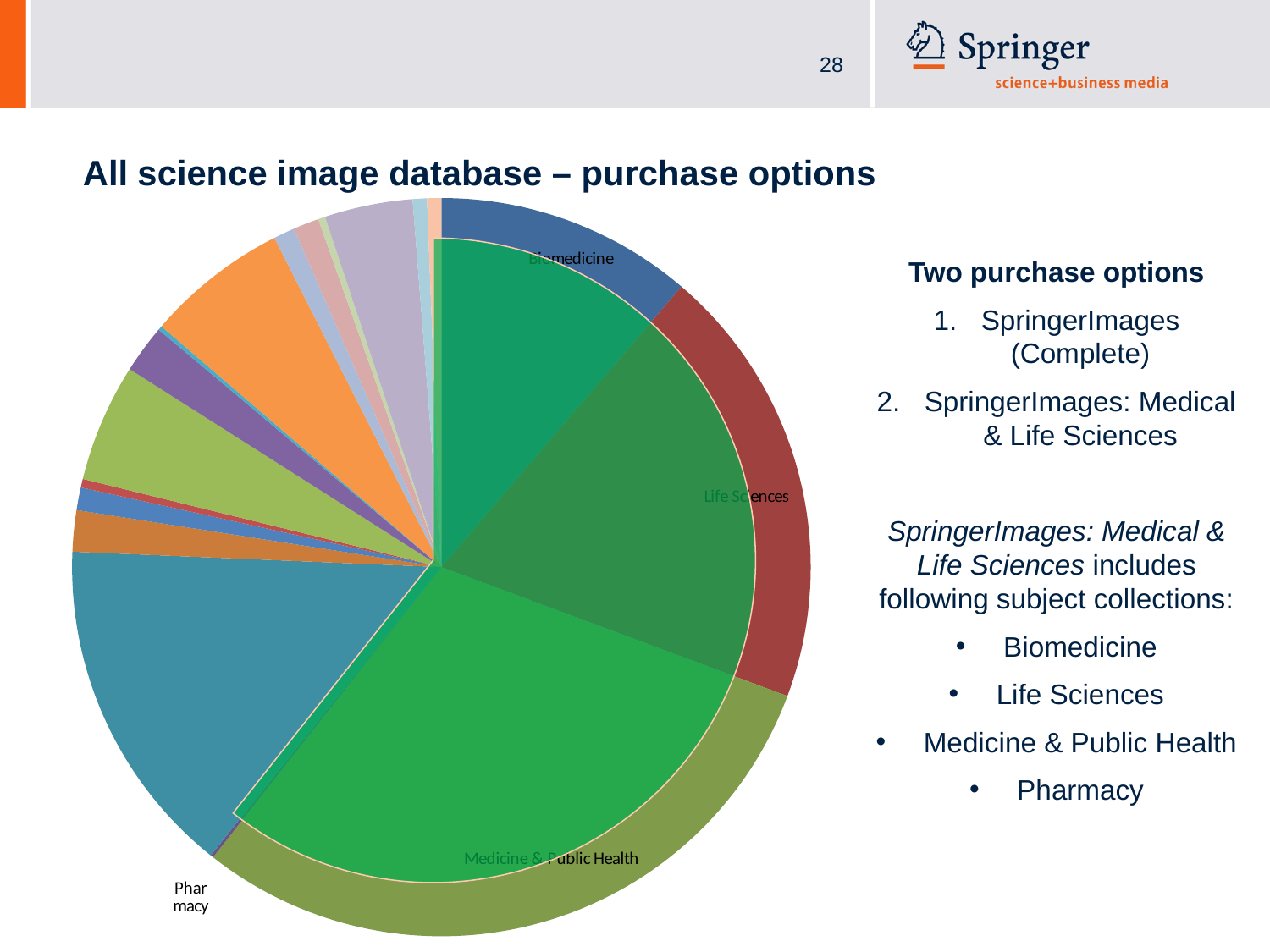
Which of the labelled slices in the pie chart is the largest? Medicine & Public Health How many slices of the pie chart have readable labels? 4 Which slice is larger in the pie chart, Biomedicine or Pharmacy? Biomedicine Which of the labelled slices in the pie chart is the smallest? Pharmacy What kind of chart is shown on the slide? pie chart Which slice is larger in the pie chart, Medicine & Public Health or Biomedicine? Medicine & Public Health Which labelled slice of the pie chart sits at the bottom-left edge of the pie? Pharmacy What is the title of the slide containing the chart? All science image database – purchase options Which slice is larger in the pie chart, Life Sciences or Pharmacy? Life Sciences